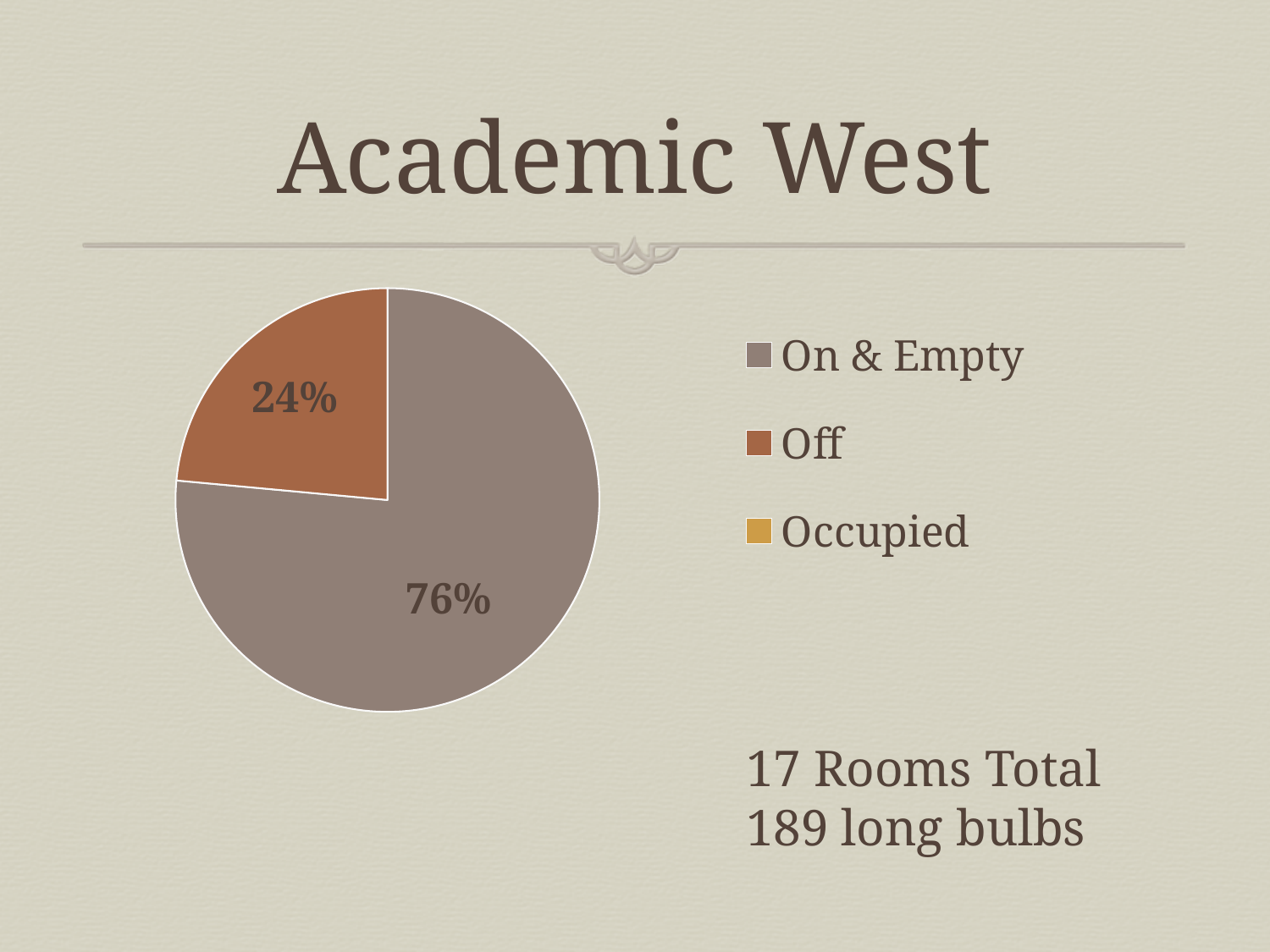
How many entries does the legend list? 3 What share of the pie is labelled "On & Empty"? 76% Which of the two labelled slices is larger, "On & Empty" or "Off"? On & Empty What kind of chart is shown on the slide? Pie chart What is the difference in percentage points between the "On & Empty" slice and the "Off" slice? 52 What colour is the "Off" slice of the pie? Orange-brown What share of the pie is labelled "Off"? 24% How many slices are visibly labelled with a percentage on the pie? 2 Which legend entry does not have a visible slice in the pie? Occupied Which category has the largest slice of the pie? On & Empty